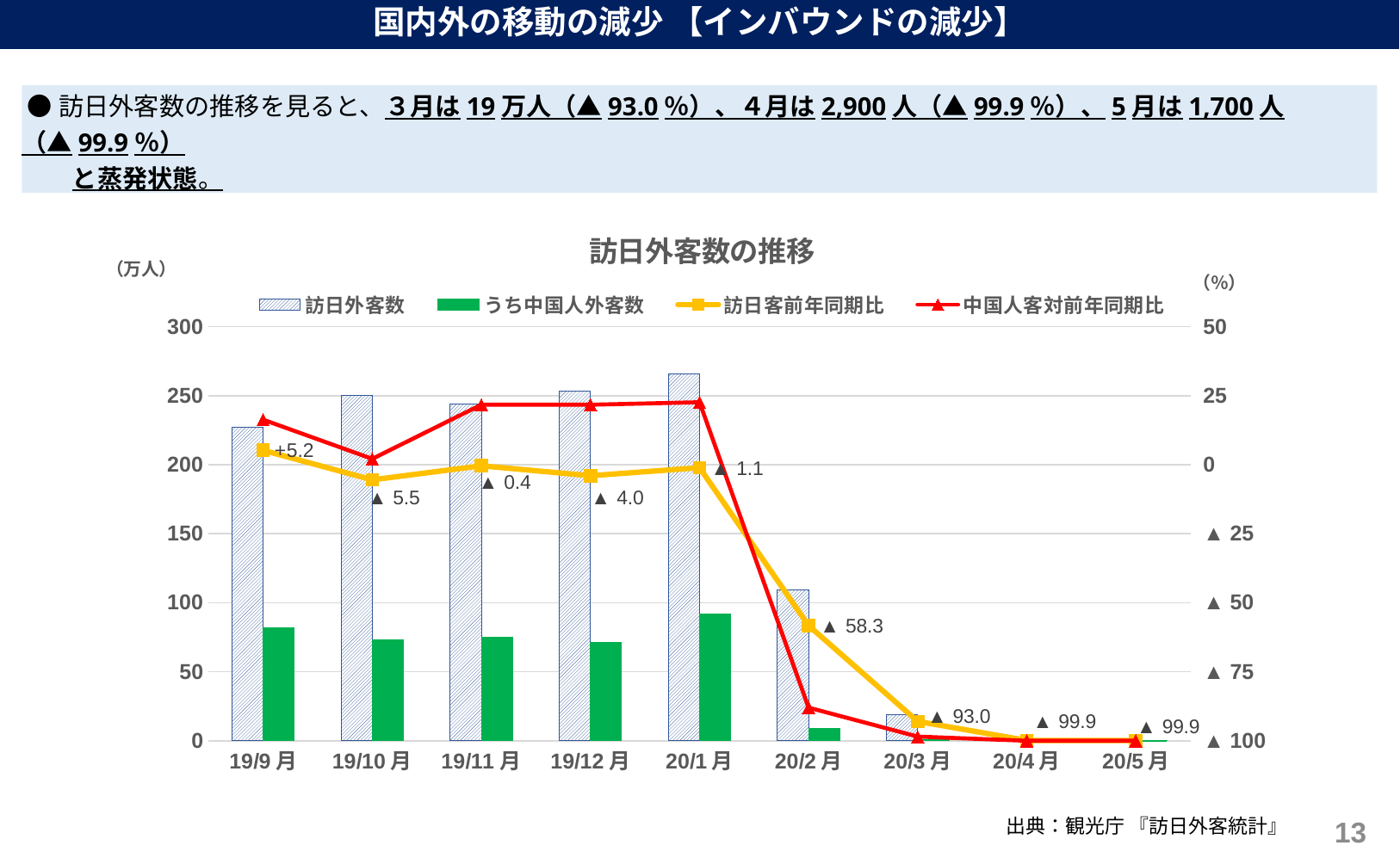
What is the 訪日客前年同期比 value for 19/9月? +5.2 Which month has the highest 訪日外客数 bar? 20/1月 What unit is shown on the left axis of the chart? 万人 Is the 訪日外客数 value for 20/2月 greater or less than 150? less What is the 訪日客前年同期比 value for 20/5月? ▲ 99.9 What is the 訪日客前年同期比 value for 20/2月? ▲ 58.3 Does the 訪日客前年同期比 line rise or fall from 20/1月 to 20/5月? It falls What is the 訪日客前年同期比 value for 20/3月? ▲ 93.0 How many months are shown on the x axis of the chart? 9 What kind of chart is shown on the slide? A combined bar and line chart Is the 訪日外客数 value for 19/9月 greater or less than 200? greater How many series does the legend of the 訪日外客数の推移 chart list? 4